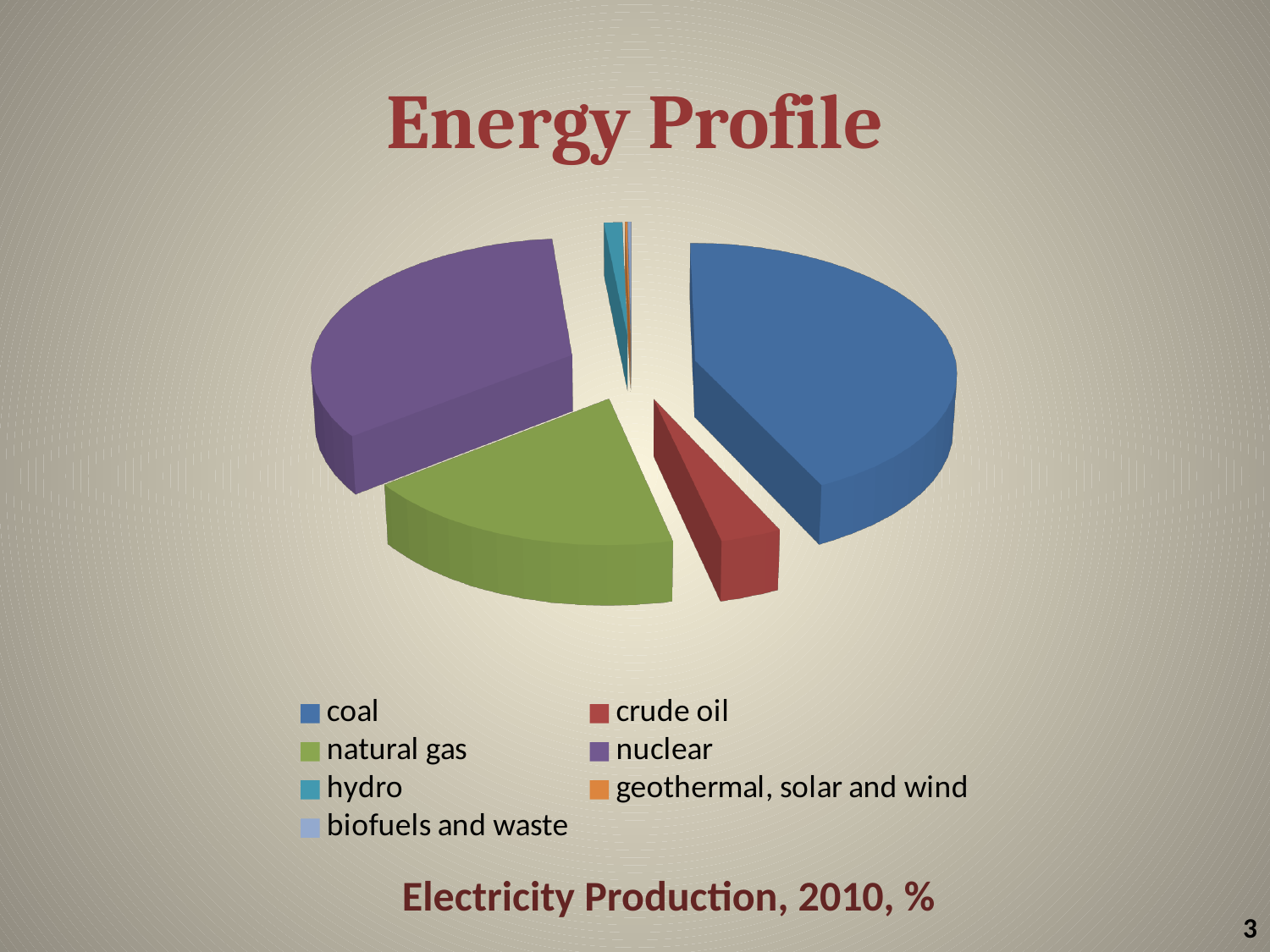
Which slice is larger, coal or crude oil? coal Which category has the largest slice of the pie chart? coal What is the title of the slide containing the pie chart? Energy Profile What colour is the coal slice in the pie chart? blue Which slice is larger, nuclear or crude oil? nuclear How many categories does the legend of the pie chart list? 7 Which slice is larger, crude oil or hydro? crude oil What kind of chart is shown on the slide? pie chart